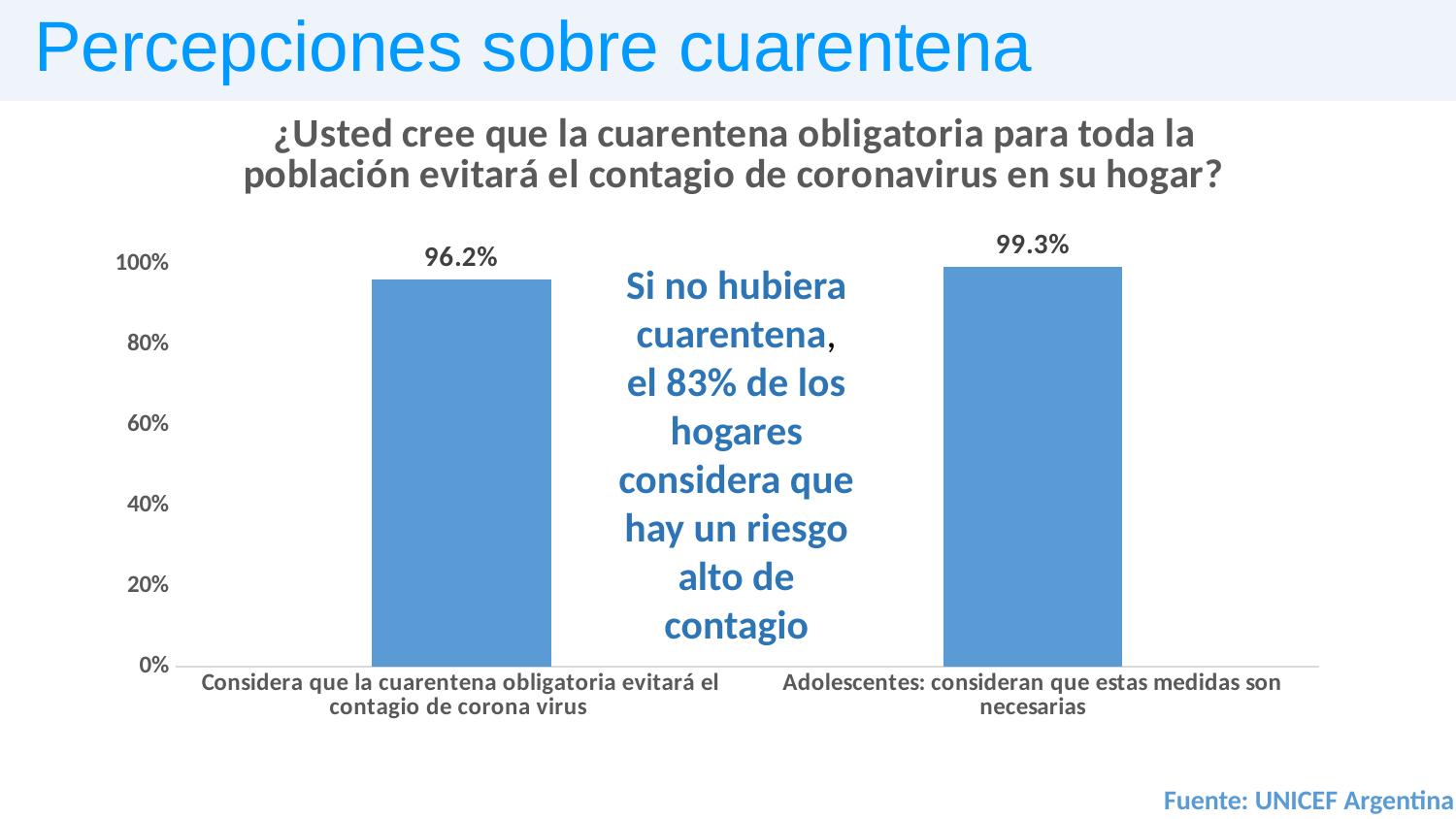
How many bars are plotted in the chart? 2 What is the title of the chart? ¿Usted cree que la cuarentena obligatoria para toda la población evitará el contagio de coronavirus en su hogar? What is the difference between the two bars' values? 3.1% What is the value for "Adolescentes: consideran que estas medidas son necesarias"? 99.3% Which category has the highest value? Adolescentes: consideran que estas medidas son necesarias Which category has the lowest value? Considera que la cuarentena obligatoria evitará el contagio de corona virus Which is larger: the value for "Considera que la cuarentena obligatoria evitará el contagio de corona virus" or for "Adolescentes: consideran que estas medidas son necesarias"? Adolescentes: consideran que estas medidas son necesarias What is the value for "Considera que la cuarentena obligatoria evitará el contagio de corona virus"? 96.2% Is the value for "Considera que la cuarentena obligatoria evitará el contagio de corona virus" greater or less than 80%? greater What is the source cited for the chart? UNICEF Argentina What is the highest value shown on the y axis? 100% What kind of chart is shown on the slide? Bar chart